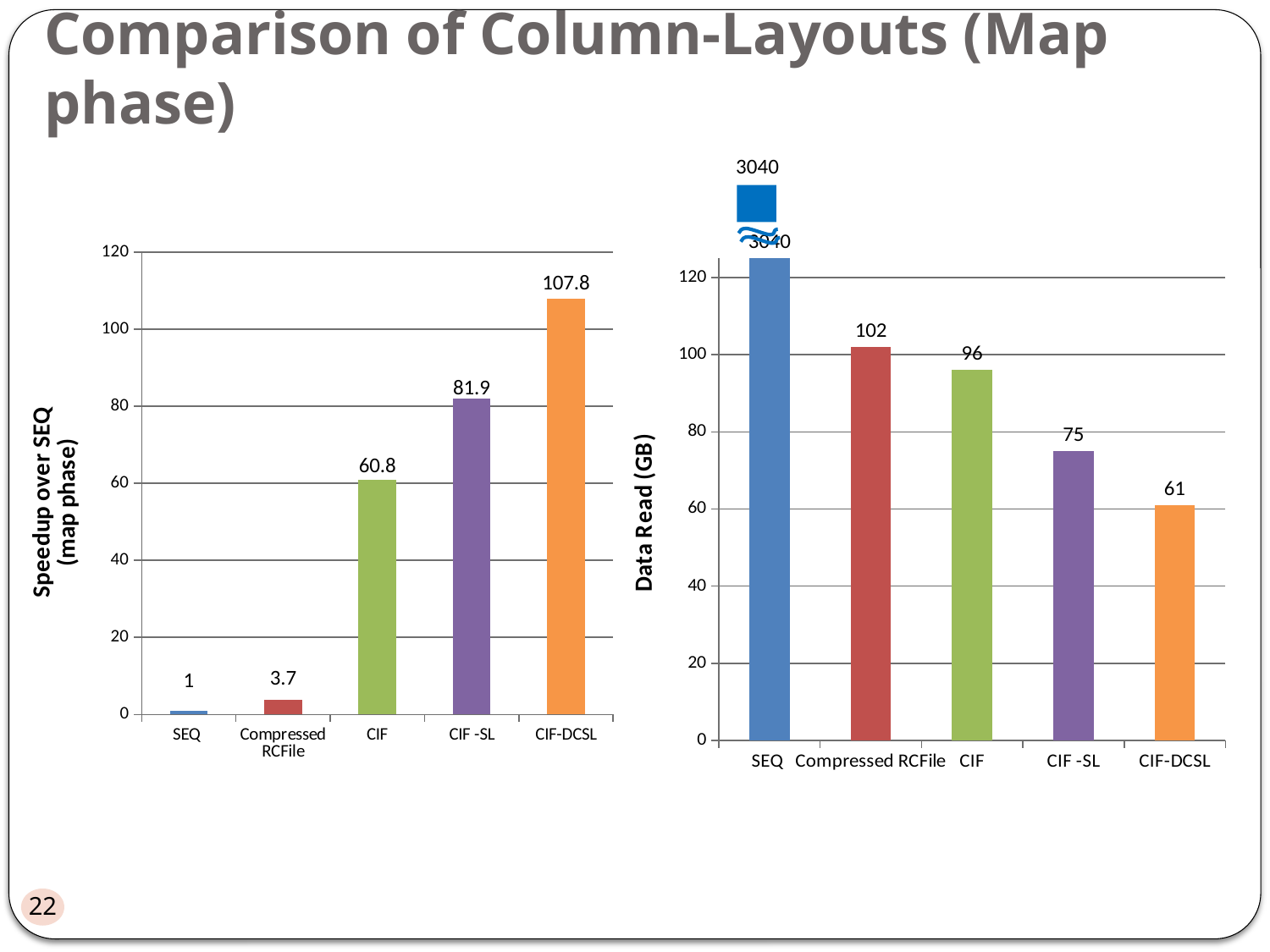
In the left chart (Speedup over SEQ), which category has the highest speedup? CIF-DCSL In the right chart (Data Read (GB)), which category has the lowest data read? CIF-DCSL In the right chart (Data Read (GB)), do the values rise or fall from left to right along the x axis? fall In the right chart (Data Read (GB)), what is the difference between the data read for Compressed RCFile and CIF? 6 In the left chart (Speedup over SEQ), what is the difference between the speedup of CIF -SL and CIF? 21.1 In the right chart (Data Read (GB)), what is the data read for SEQ? 3040 In the right chart (Data Read (GB)), what is the data read for CIF -SL? 75 In the left chart (Speedup over SEQ), what is the speedup for CIF-DCSL? 107.8 In the left chart (Speedup over SEQ), which category has the lowest speedup? SEQ In the left chart (Speedup over SEQ), what is the speedup for Compressed RCFile? 3.7 What kind of chart is the left chart (Speedup over SEQ)? bar chart In the left chart (Speedup over SEQ), how many categories are shown on the x axis? 5